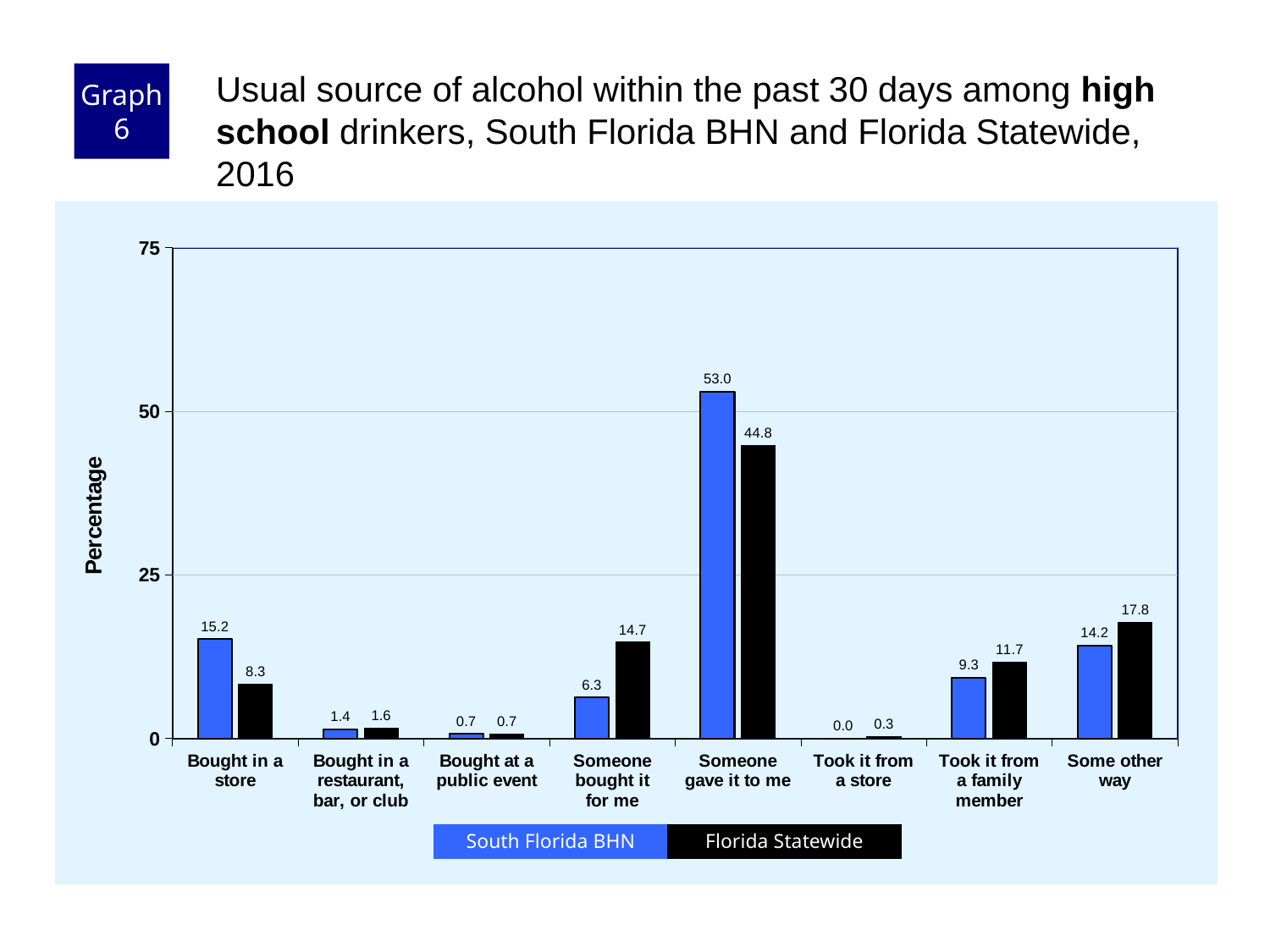
Is the Florida Statewide value for "Someone gave it to me" greater or less than 50? less What is the Florida Statewide value for "Some other way"? 17.8 What is the Florida Statewide value for "Bought in a store"? 8.3 How many series does the legend list? 2 For "Someone bought it for me", which is larger: South Florida BHN or Florida Statewide? Florida Statewide How many categories are shown on the x axis? 8 What is the label of the y axis? Percentage Which category has the highest South Florida BHN value? Someone gave it to me What is the South Florida BHN value for "Someone gave it to me"? 53.0 What kind of chart is shown on the slide? bar chart Which category has the lowest South Florida BHN value? Took it from a store What is the difference between the South Florida BHN and Florida Statewide values for "Someone gave it to me"? 8.2